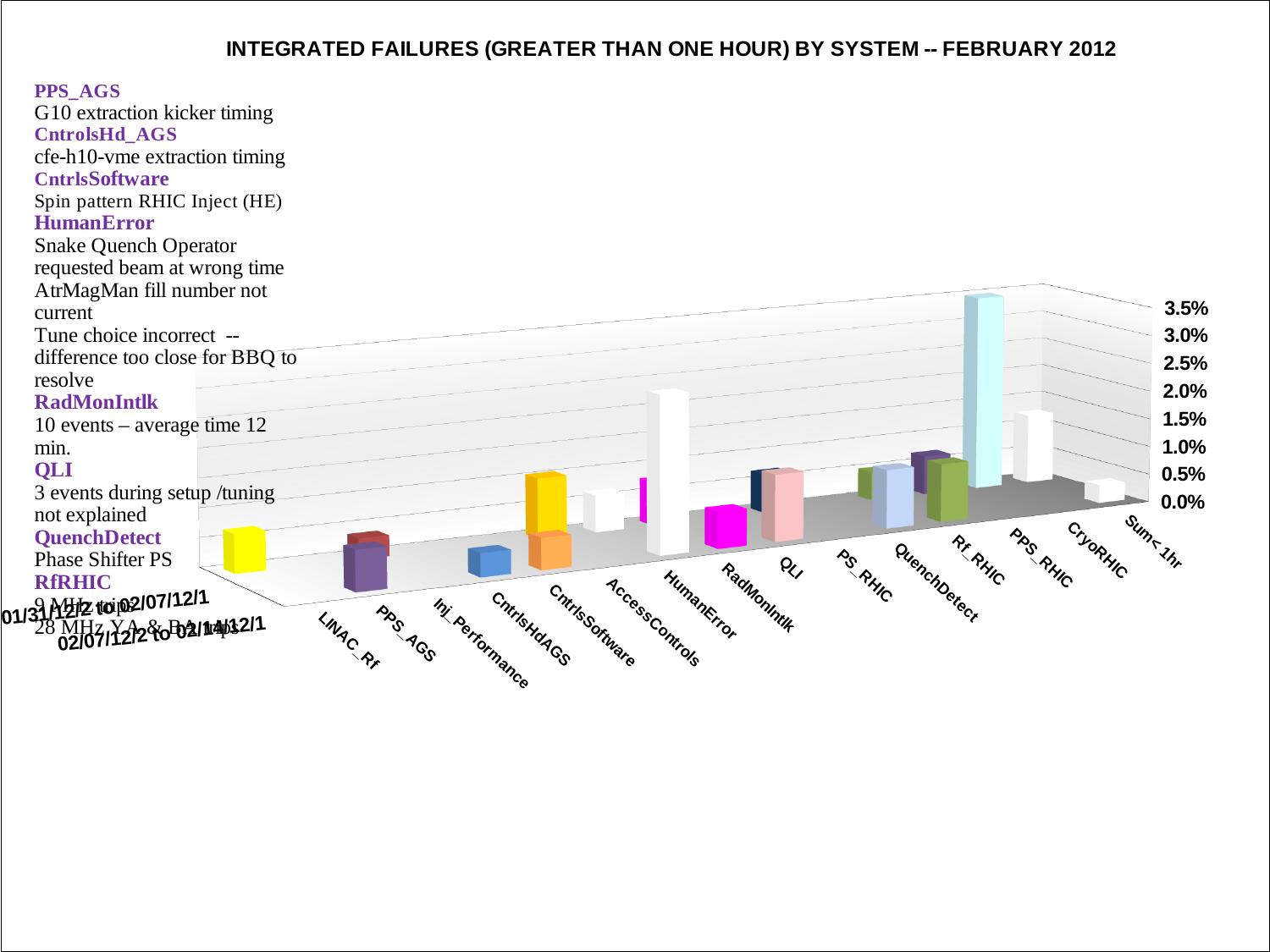
Is the tallest bar for LINAC_Rf greater or less than 1.5%? less Which has a taller bar, AccessControls or Inj_Performance? AccessControls Is the tallest bar for CryoRHIC greater or less than 1.0%? greater What kind of chart is shown on the slide? bar chart How many system categories are shown along the x axis of the chart? 15 Is the tallest bar for Rf_RHIC greater or less than 2.5%? less Which system has the tallest bar in the chart? CryoRHIC What is the highest value labelled on the vertical axis of the chart? 3.5% What is the title of the chart? INTEGRATED FAILURES (GREATER THAN ONE HOUR) BY SYSTEM -- FEBRUARY 2012